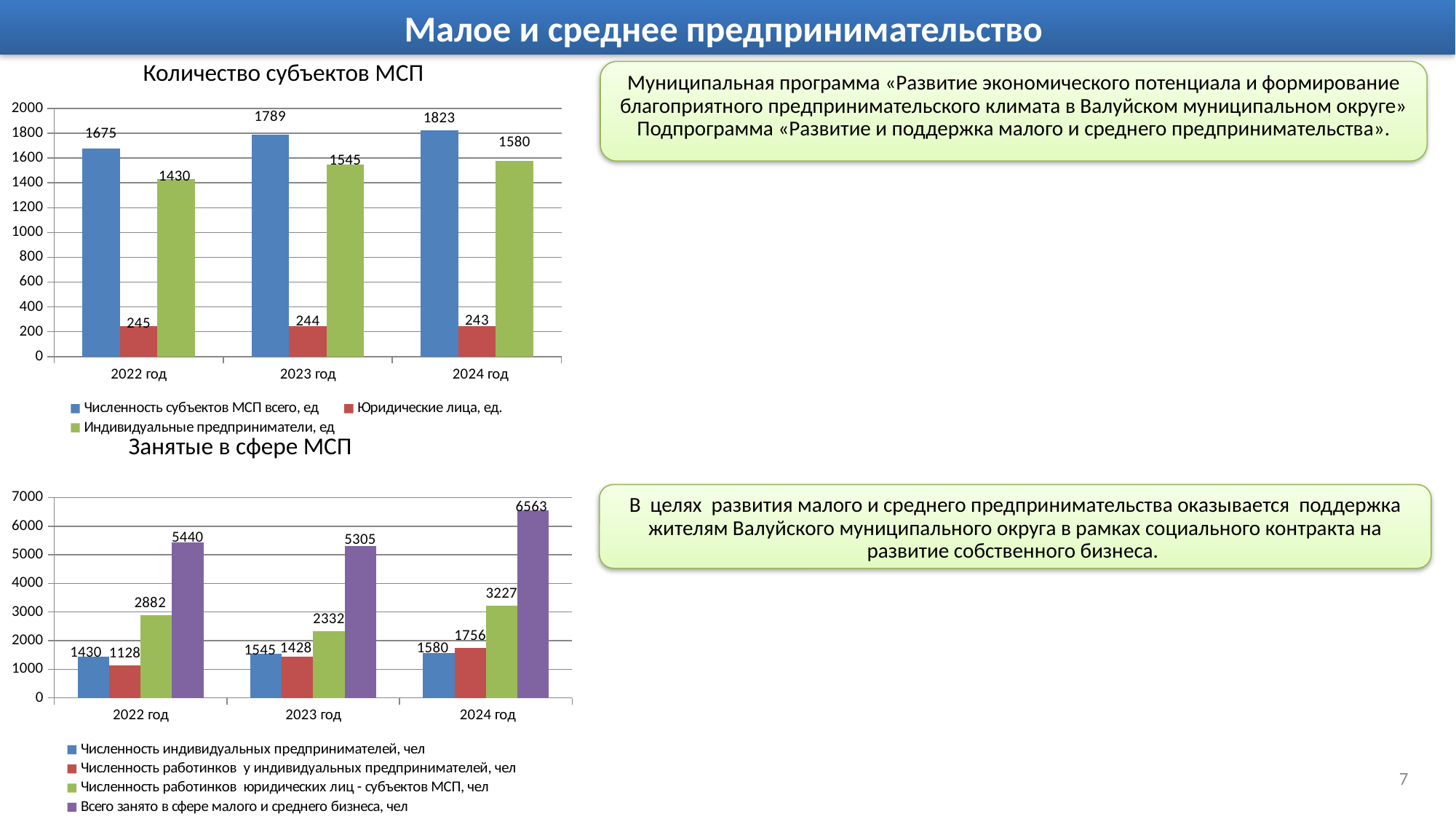
How many series does the legend of the chart "Занятые в сфере МСП" list? 4 In the chart "Количество субъектов МСП", what is the value of "Численность субъектов МСП всего, ед" for 2023 год? 1789 In the chart "Количество субъектов МСП", what is the difference between "Численность субъектов МСП всего, ед" in 2024 год and in 2022 год? 148 In the chart "Занятые в сфере МСП", what is the value of "Всего занято в сфере малого и среднего бизнеса, чел" for 2024 год? 6563 What type of chart is "Занятые в сфере МСП"? bar chart In the chart "Количество субъектов МСП", what is the value of "Индивидуальные предприниматели, ед" for 2022 год? 1430 In the chart "Количество субъектов МСП", in which year is "Юридические лица, ед." lowest? 2024 год In the chart "Занятые в сфере МСП", which is larger in 2022 год: "Численность индивидуальных предпринимателей, чел" or "Численность работинков у индивидуальных предпринимателей, чел"? Численность индивидуальных предпринимателей, чел In the chart "Количество субъектов МСП", does "Численность субъектов МСП всего, ед" rise or fall from 2022 год to 2024 год? rise In the chart "Занятые в сфере МСП", what is the value of "Численность работинков юридических лиц - субъектов МСП, чел" for 2023 год? 2332 How many series does the legend of the chart "Количество субъектов МСП" list? 3 In the chart "Занятые в сфере МСП", in which year is "Всего занято в сфере малого и среднего бизнеса, чел" lowest? 2023 год